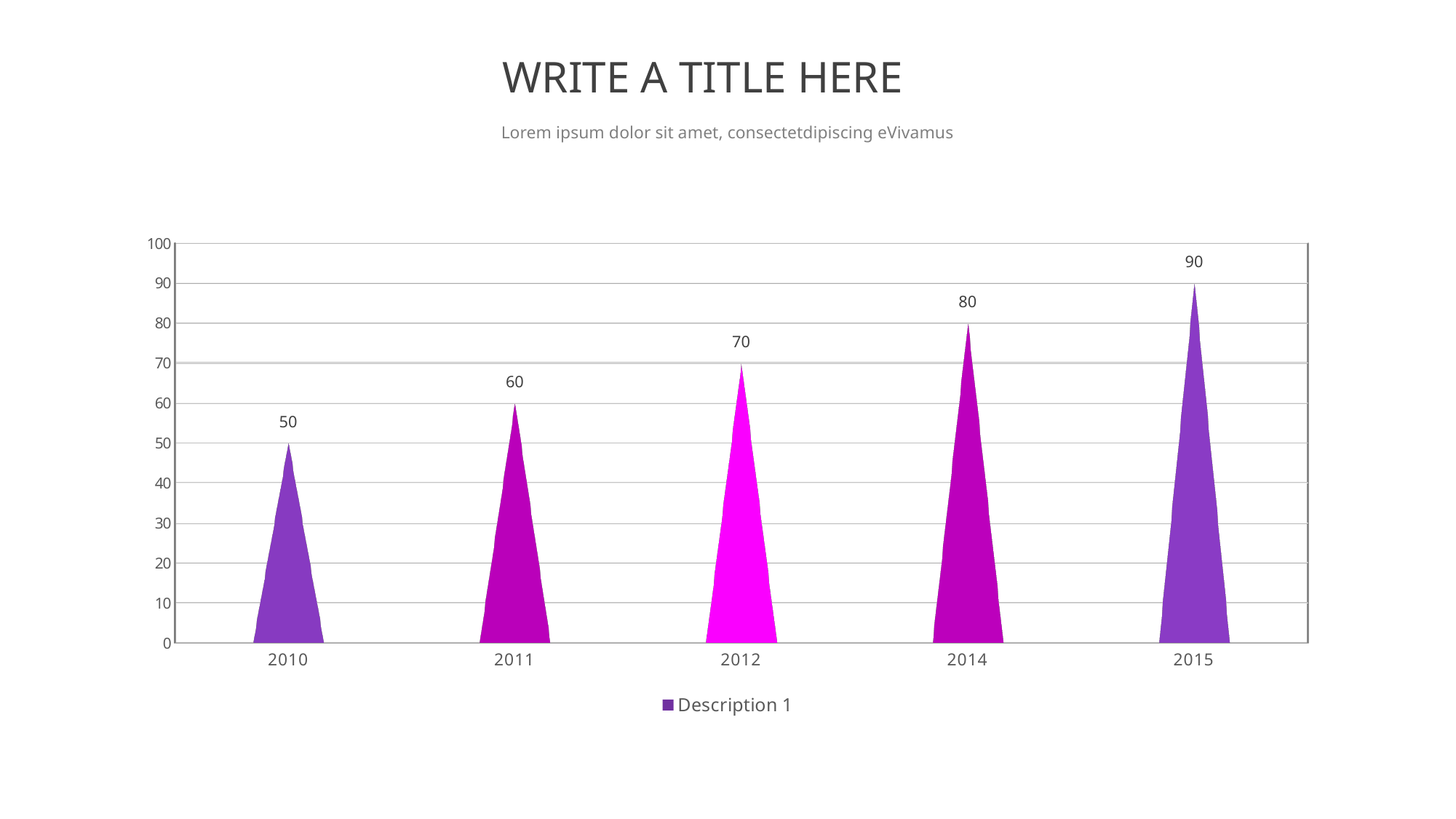
What is the name of the series shown in the legend? Description 1 Which year has the highest value? 2015 Do the values rise or fall from 2010 to 2015? rise What is the difference between the values for 2015 and 2010? 40 Which is larger, the value for 2011 or the value for 2014? 2014 How many categories are shown on the x axis? 5 How many series does the legend list? 1 What is the value for 2012? 70 Which year has the lowest value? 2010 What is the difference between the values for 2014 and 2011? 20 What is the value for 2010? 50 What is the value for 2015? 90